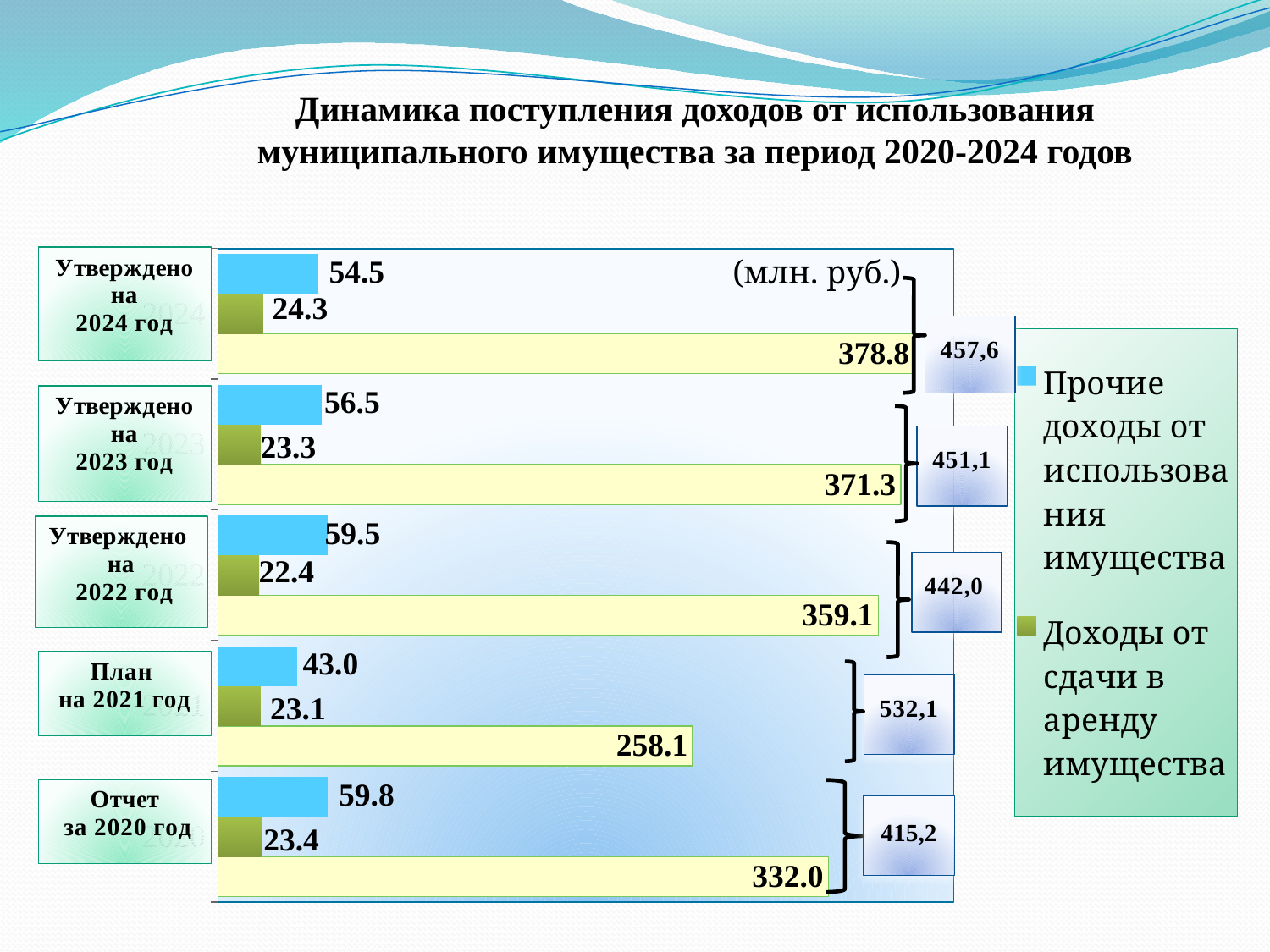
Which year has the highest value for the blue series (Прочие доходы от использования имущества)? Отчет за 2020 год How many year categories are shown in the chart? 5 What total is shown in the box next to Утверждено на 2023 год? 451,1 How many series does the legend list? 2 What is the value of the yellow bar for План на 2021 год? 258.1 What kind of chart is shown on the slide? Bar chart What is the difference between the blue series values for Утверждено на 2022 год and План на 2021 год? 16.5 Which year has the lowest value for the yellow bar? План на 2021 год What is the value of the blue series (Прочие доходы от использования имущества) for Утверждено на 2024 год? 54.5 What is the value of the green series (Доходы от сдачи в аренду имущества) for Отчет за 2020 год? 23.4 What unit is indicated for the values in the chart? млн. руб. Which is larger: the green series value for Утверждено на 2024 год or for Утверждено на 2022 год? Утверждено на 2024 год